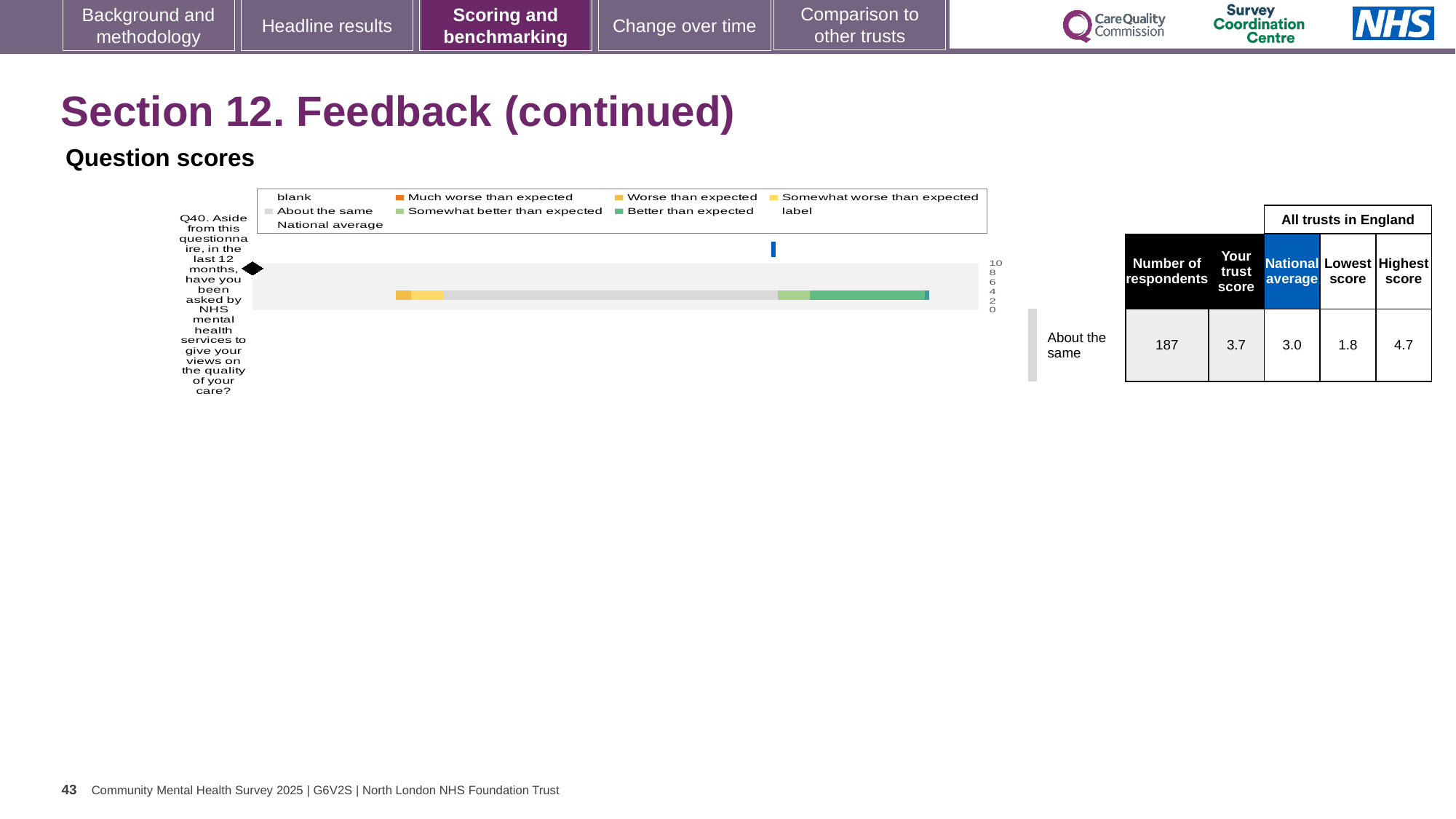
In the table beside the chart, what is the number of respondents for Q40? 187 Which segment takes up the largest part of the Q40 bar? About the same In the table beside the chart, which is larger for Q40: the trust's score or the national average? Your trust score In the table beside the chart, what is the trust's score for Q40? 3.7 Which legend entry is shown in orange in the chart? Much worse than expected In the table beside the chart, what is the national average for Q40? 3.0 In the Q40 bar, which segment is wider: "Better than expected" or "Worse than expected"? Better than expected How many questions (categories) are plotted in the chart? 1 What kind of chart is shown on the slide? bar chart How many entries does the chart's legend list? 9 In the table beside the chart, what is the difference between the highest score and the lowest score for Q40? 2.9 Which question number is plotted in the chart? Q40